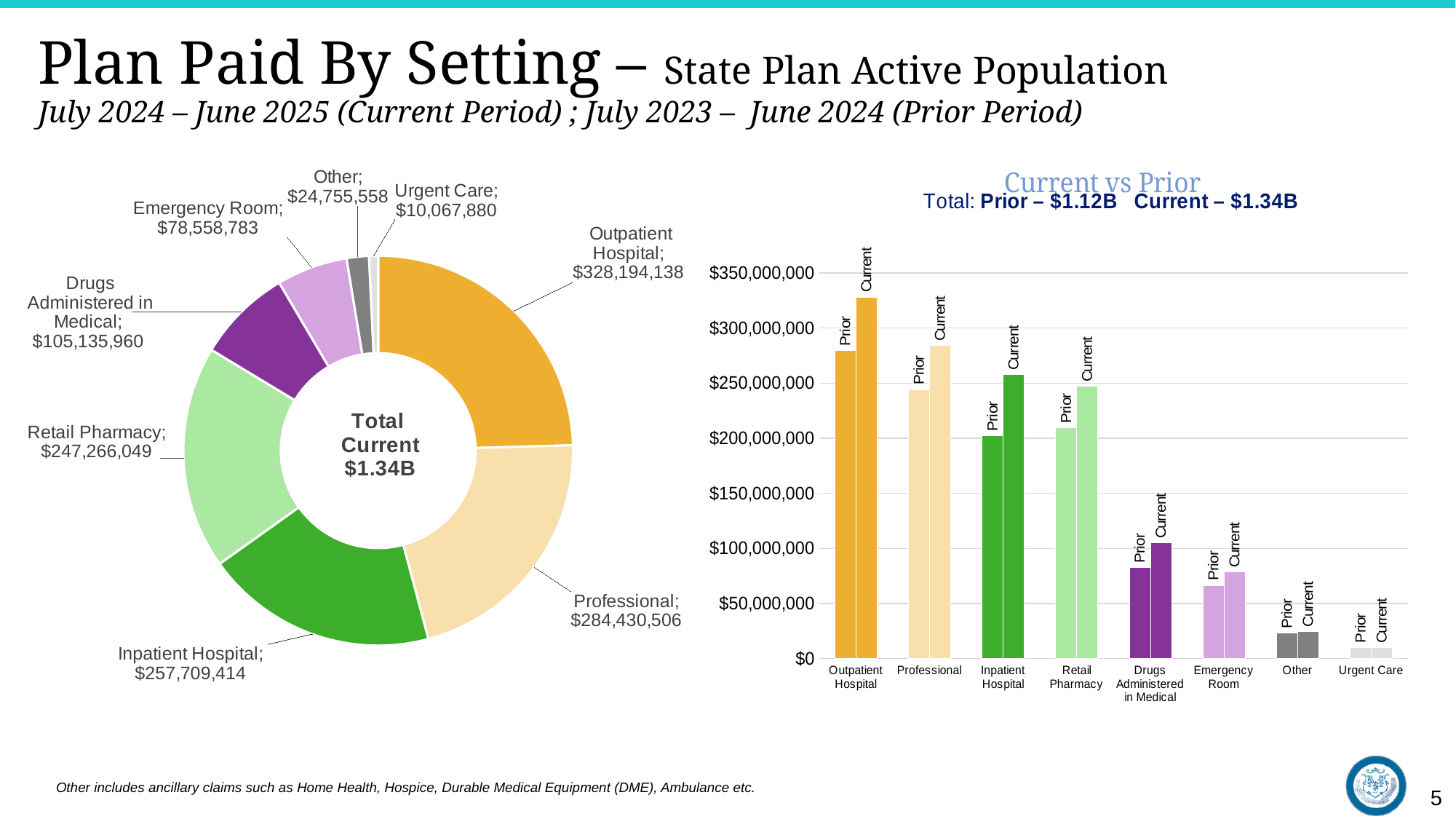
On the donut chart on the left, what is the value for Urgent Care? $10,067,880 On the donut chart on the left, what total is shown in the centre? Total Current $1.34B On the Current vs Prior chart on the right, how many setting categories are shown on the x axis? 8 On the donut chart on the left, which is larger: Inpatient Hospital or Retail Pharmacy? Inpatient Hospital On the donut chart on the left, what is the value for Outpatient Hospital? $328,194,138 On the donut chart on the left, what is the value for Retail Pharmacy? $247,266,049 On the donut chart on the left, which setting has the lowest plan paid amount? Urgent Care On the Current vs Prior chart on the right, is the Prior value for Drugs Administered in Medical greater or less than $100,000,000? less What kind of chart is the Current vs Prior chart on the right? bar chart On the donut chart on the left, what is the difference between Outpatient Hospital and Professional? $43,763,632 On the Current vs Prior chart on the right, is the Prior value for Outpatient Hospital greater or less than $250,000,000? greater On the donut chart on the left, which setting has the highest plan paid amount? Outpatient Hospital